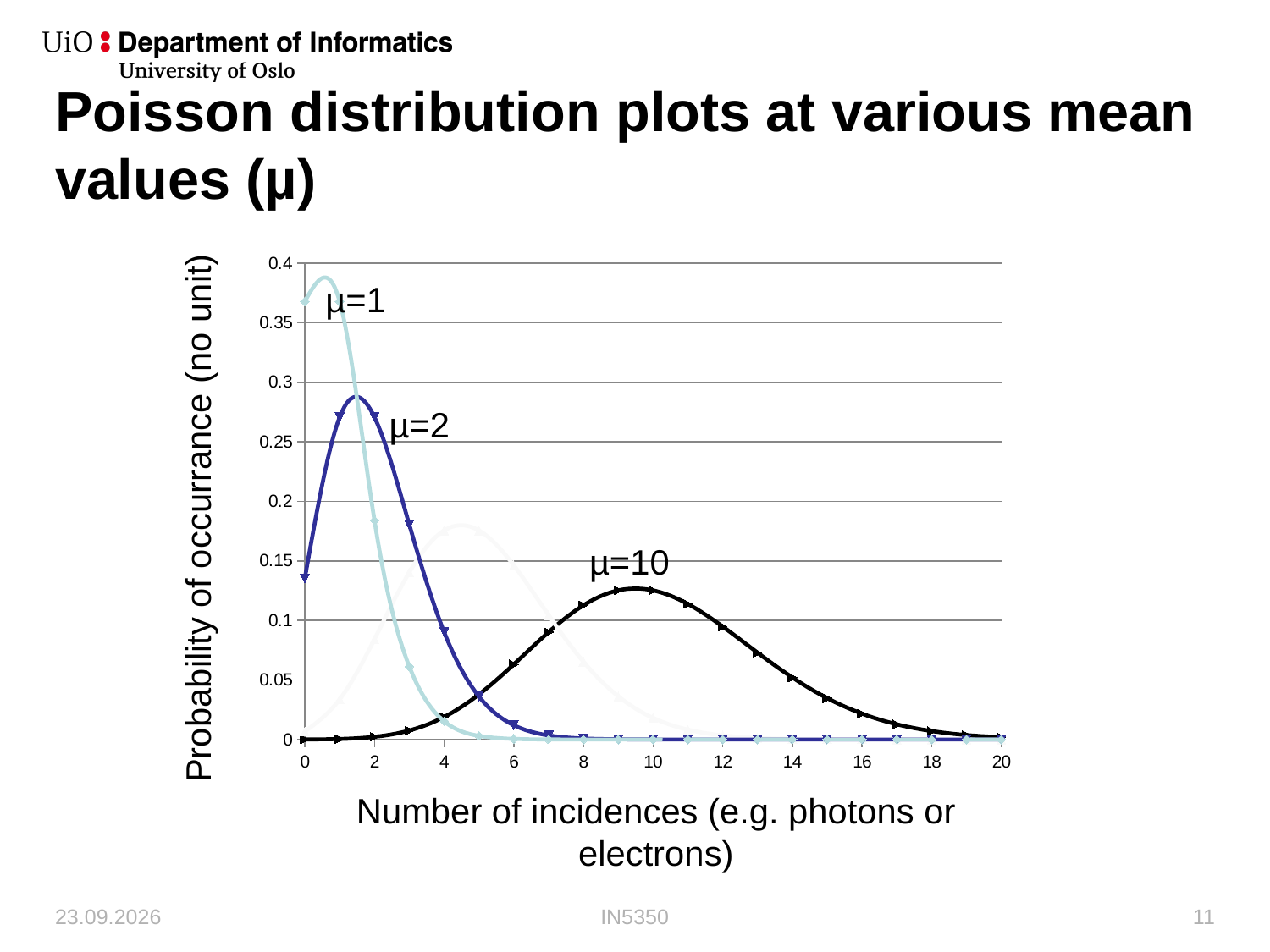
Is the peak value of the μ=2 curve greater or less than 0.3? less What is the label of the y axis? Probability of occurrance (no unit) At 10 incidences, which curve has the larger probability, μ=10 or μ=2? μ=10 How many curves on the chart are labeled with a μ value? 3 What is the title of the chart on the slide? Poisson distribution plots at various mean values (μ) Which labeled curve reaches the highest peak probability? μ=1 Is the value of the μ=10 curve at 20 incidences greater or less than 0.05? less What kind of chart is shown on the slide? line chart Does the μ=10 curve rise or fall as the number of incidences goes from 10 to 20? fall Is the peak value of the μ=1 curve greater or less than 0.35? greater Which labeled curve has the lowest peak probability? μ=10